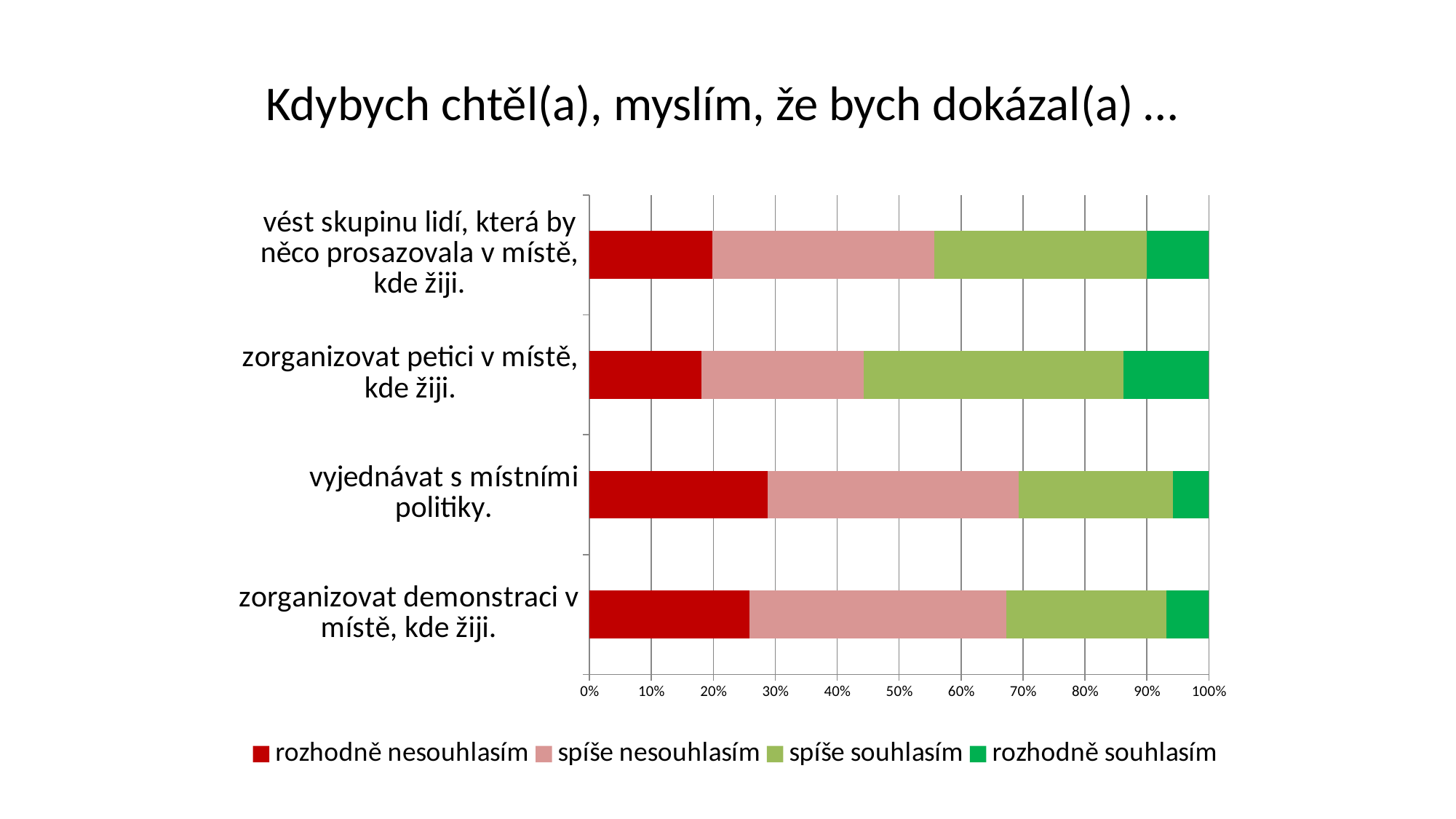
Is the 'rozhodně nesouhlasím' value for 'vyjednávat s místními politiky.' greater or less than 20%? greater What kind of chart is shown on the slide? stacked bar chart Which has the larger 'spíše nesouhlasím' segment: 'vést skupinu lidí, která by něco prosazovala v místě, kde žiji.' or 'zorganizovat petici v místě, kde žiji.'? vést skupinu lidí, která by něco prosazovala v místě, kde žiji. Is the 'rozhodně souhlasím' value for 'zorganizovat petici v místě, kde žiji.' greater or less than 10%? greater How many categories (statements) are plotted on the chart? 4 How many series does the legend list? 4 Which category has the largest 'spíše souhlasím' segment? zorganizovat petici v místě, kde žiji. What is the title of the chart? Kdybych chtěl(a), myslím, že bych dokázal(a) … Which legend entry is shown in dark red? rozhodně nesouhlasím Is the 'rozhodně nesouhlasím' value for 'vést skupinu lidí, která by něco prosazovala v místě, kde žiji.' greater or less than 30%? less What is the total of each stacked bar on the chart? 100% Which category has the largest 'rozhodně souhlasím' segment? zorganizovat petici v místě, kde žiji.